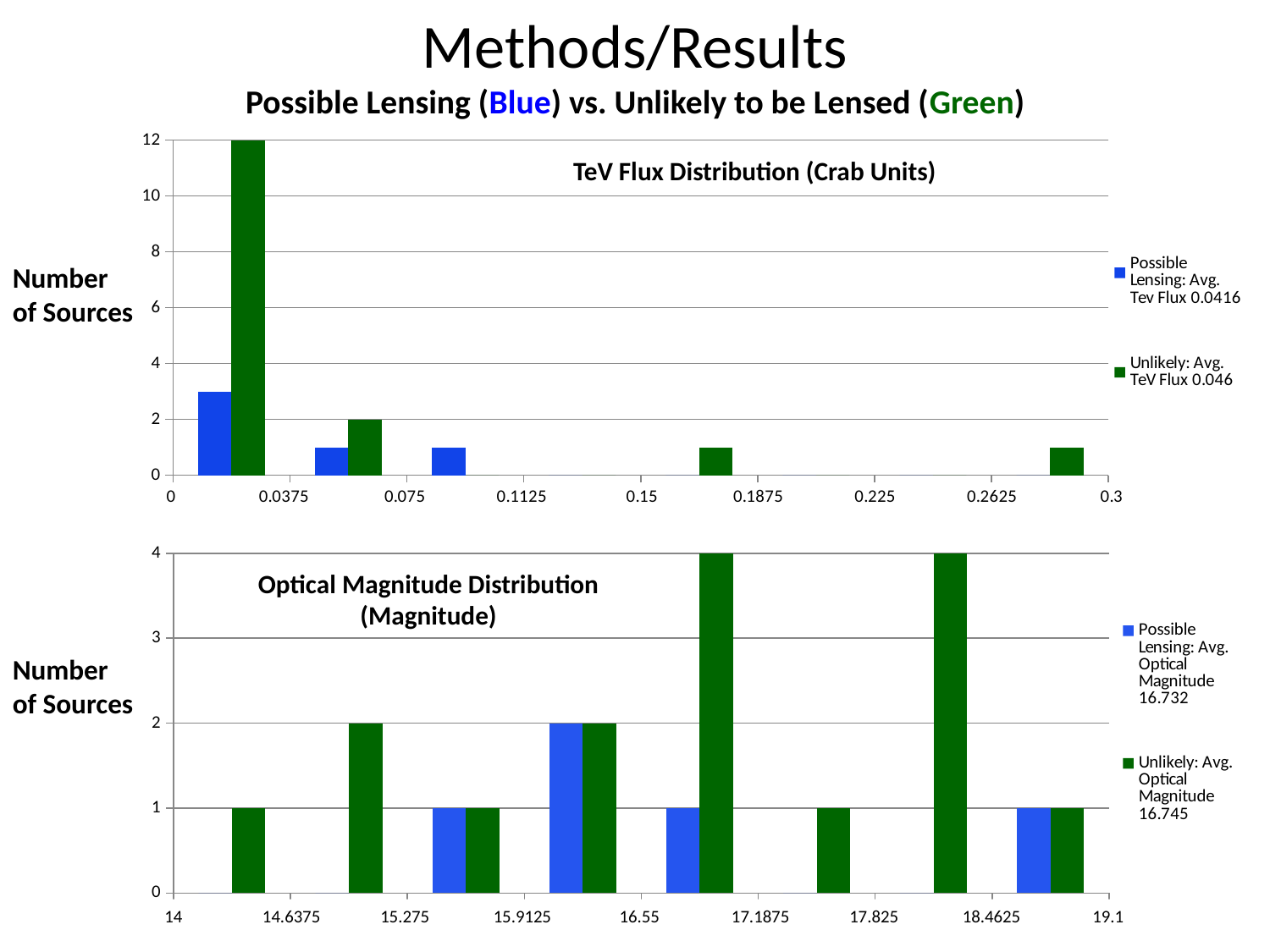
How many blue bars are plotted in the Optical Magnitude Distribution (Magnitude) chart? 4 In the TeV Flux Distribution (Crab Units) chart, what value does the tallest green bar reach? 12 How many series does the legend of the TeV Flux Distribution (Crab Units) chart list? 2 In the Optical Magnitude Distribution (Magnitude) chart, what is the difference between the tallest green bar and the tallest blue bar? 2 In the Optical Magnitude Distribution (Magnitude) chart, what value does the tallest blue bar reach? 2 According to the legend of the TeV Flux Distribution (Crab Units) chart, what is the average TeV flux for the Possible Lensing series? 0.0416 In the TeV Flux Distribution (Crab Units) chart, what value does the second-tallest green bar reach? 2 In the Optical Magnitude Distribution (Magnitude) chart, what is the highest value reached by any bar? 4 What kind of chart is the TeV Flux Distribution (Crab Units) chart? bar chart In the TeV Flux Distribution (Crab Units) chart, is the tallest blue bar greater or less than 2? greater How many blue bars are plotted in the TeV Flux Distribution (Crab Units) chart? 3 In the TeV Flux Distribution (Crab Units) chart, which series has the tallest bar, Possible Lensing (blue) or Unlikely (green)? Unlikely (green)